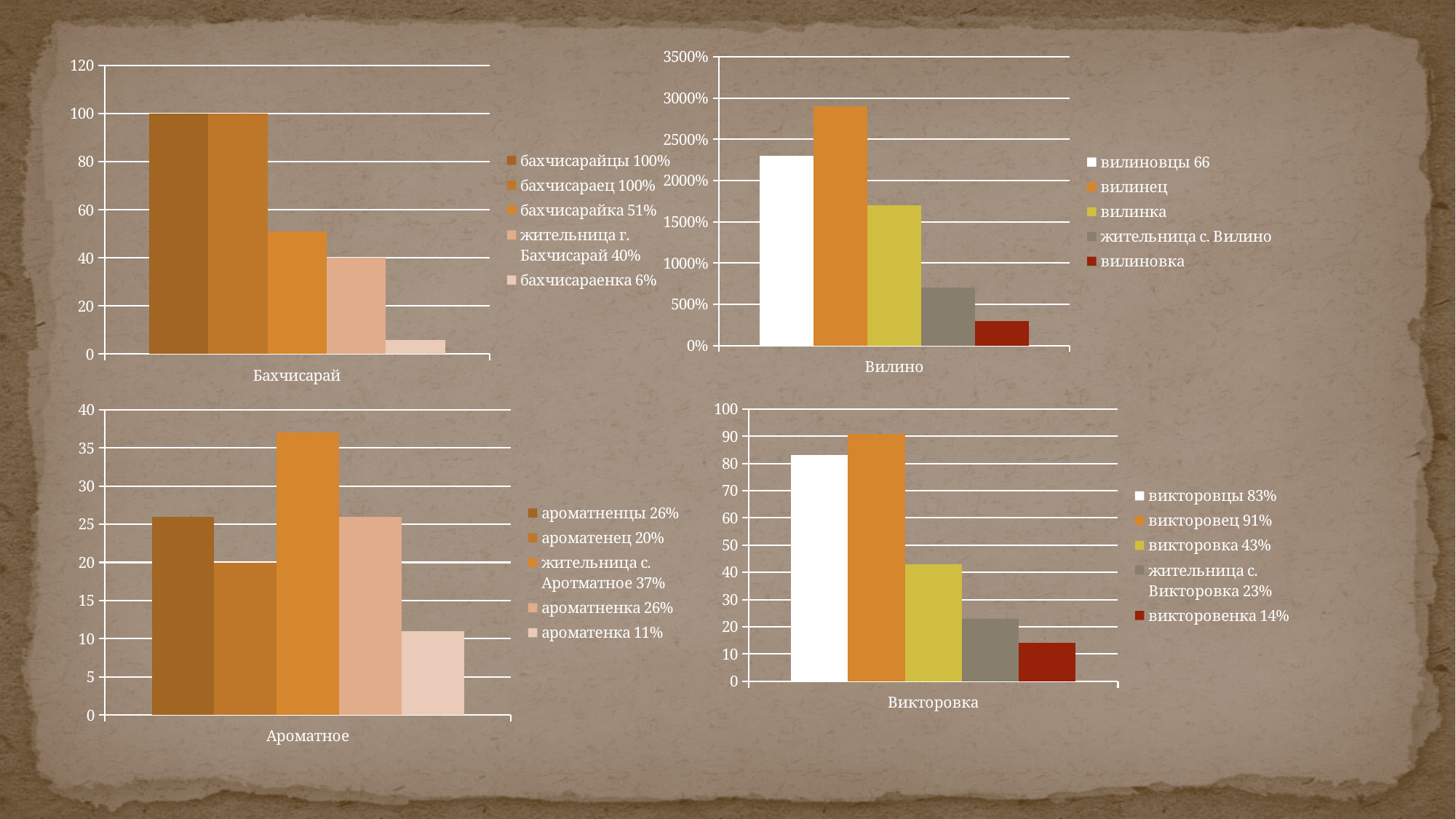
In the Бахчисарай chart, what value does the legend give for бахчисарайка? 51% In the Ароматное chart, what value does the legend give for ароматенка? 11% In the Викторовка chart, what value does the legend give for викторовенка? 14% In the Вилино chart, how many series does the legend list? 5 In the Вилино chart, is the value for вилинец greater or less than 2500%? greater In the Викторовка chart, what is the difference between the values for викторовец and викторовцы? 8% In the Ароматное chart, which is larger, ароматенец or ароматненка? ароматненка In the Ароматное chart, which series has the highest value? жительница с. Аротматное What kind of chart is the Викторовка chart? bar chart In the Бахчисарай chart, what is the difference between the values for бахчисарайка and жительница г. Бахчисарай? 11% In the Бахчисарай chart, which series has the lowest value? бахчисараенка In the Вилино chart, which series has the highest bar? вилинец